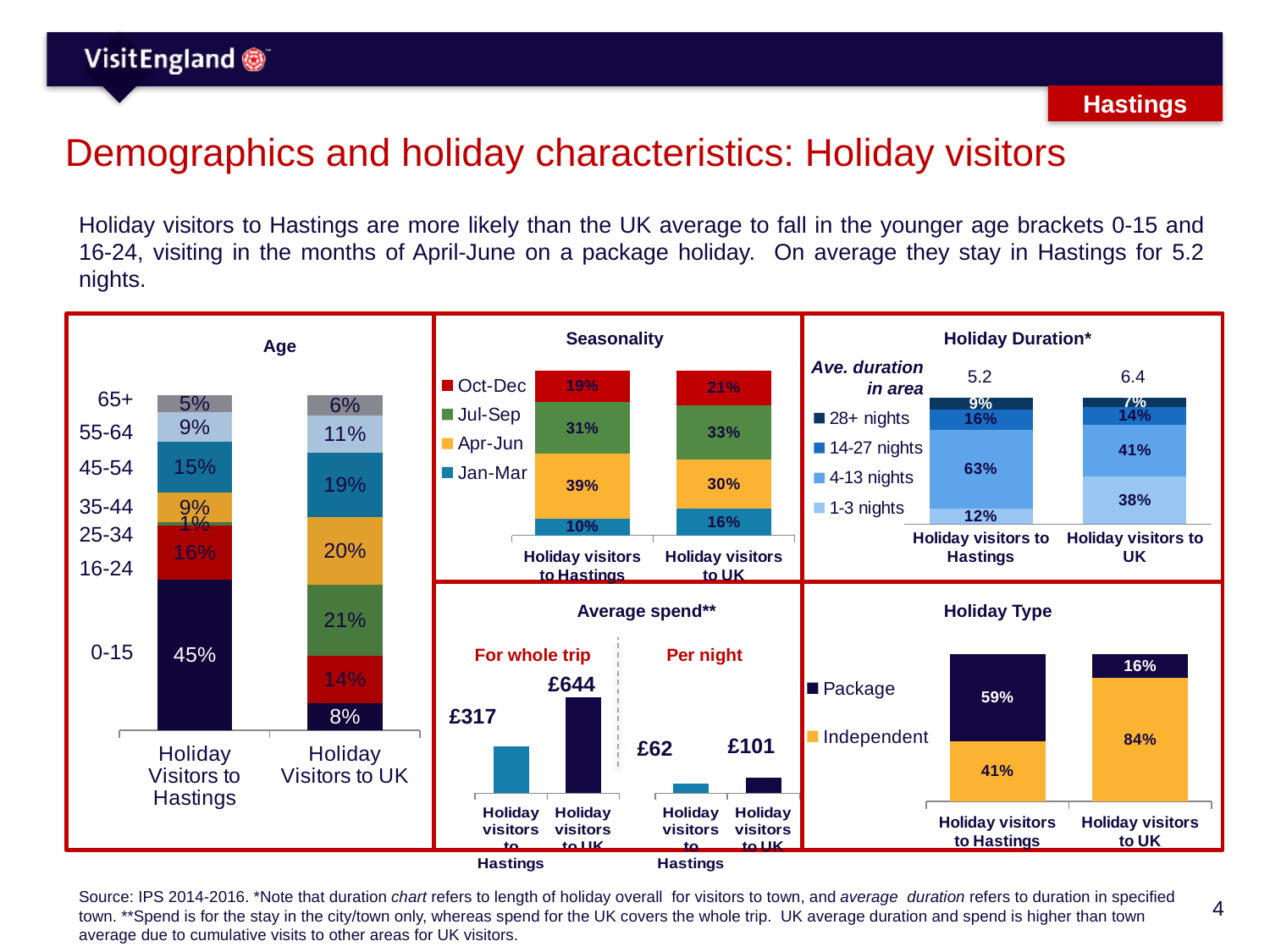
How many series does the legend of the Seasonality chart list? 4 In the Seasonality chart, what percentage of holiday visitors to Hastings visit in Apr-Jun? 39% What kind of chart is the Holiday Type chart? Stacked bar chart In the Holiday Duration chart, what is the average duration in area for holiday visitors to Hastings? 5.2 In the Average spend chart, what is the average spend for the whole trip for holiday visitors to the UK? £644 In the Holiday Type chart, which is larger for holiday visitors to Hastings: Package or Independent? Package In the Holiday Type chart, what percentage of holiday visitors to the UK are on an Independent holiday? 84% In the Seasonality chart, what is the difference between the Jan-Mar share for holiday visitors to the UK and for holiday visitors to Hastings? 6% In the Average spend chart, what is the difference between the per night spend of holiday visitors to the UK and holiday visitors to Hastings? £39 In the Holiday Duration chart, what percentage of holiday visitors to Hastings stay 4-13 nights? 63% In the Age chart, what percentage of holiday visitors to Hastings are aged 0-15? 45% In the Age chart, which age group has the largest share of holiday visitors to the UK? 25-34